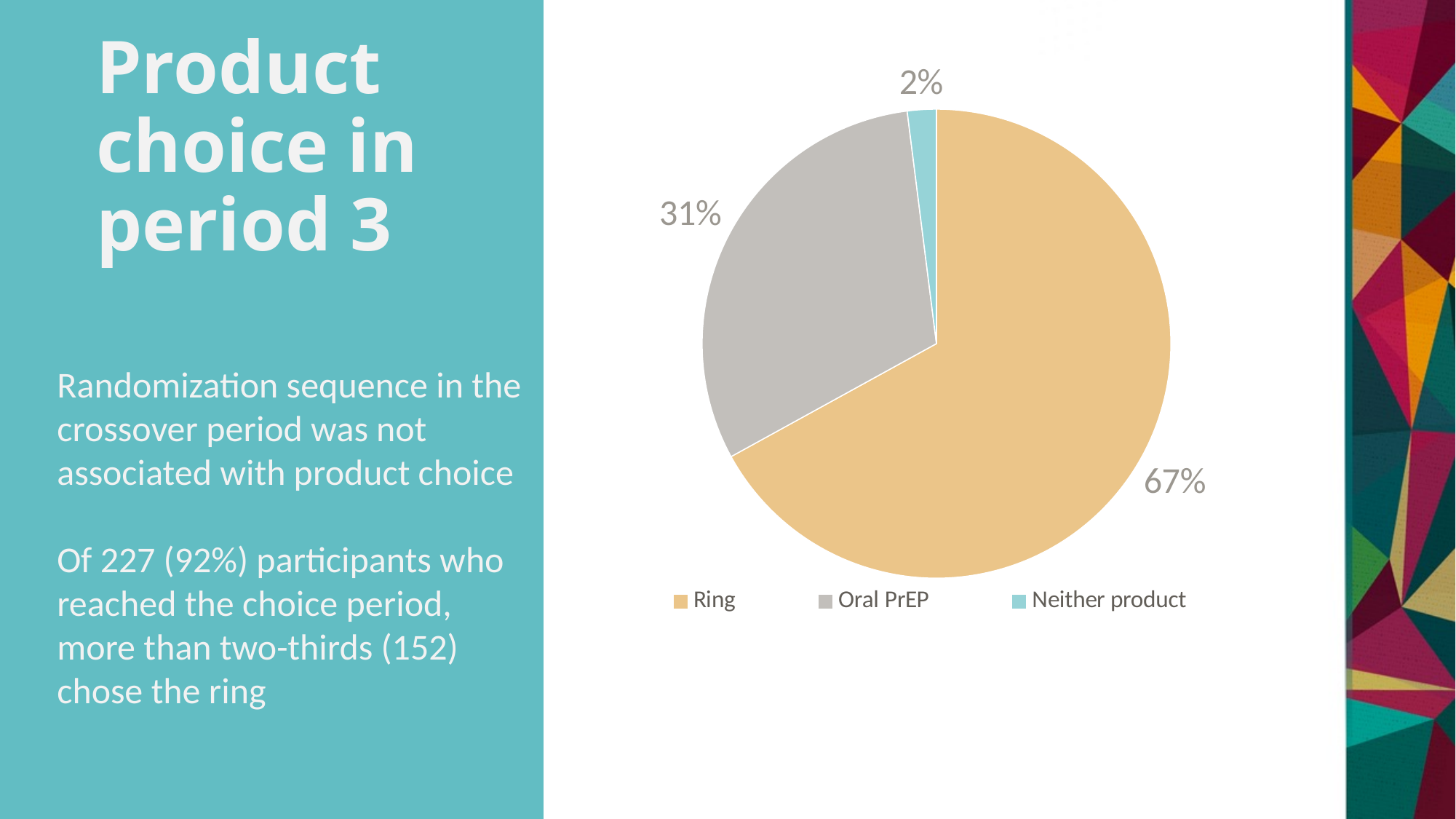
How many entries does the legend list? 3 What share of the pie does Neither product account for? 2% What share of the pie does Oral PrEP account for? 31% What colour is the Ring slice? tan/gold What is the difference in percentage points between the Ring and Oral PrEP slices? 36 What kind of chart is shown on the slide? pie chart Which category has the smallest slice of the pie? Neither product What share of the pie does Ring account for? 67% What is the difference in percentage points between the Oral PrEP and Neither product slices? 29 How many categories does the pie chart show? 3 Which category has the largest slice of the pie? Ring Which slice is larger, Oral PrEP or Neither product? Oral PrEP